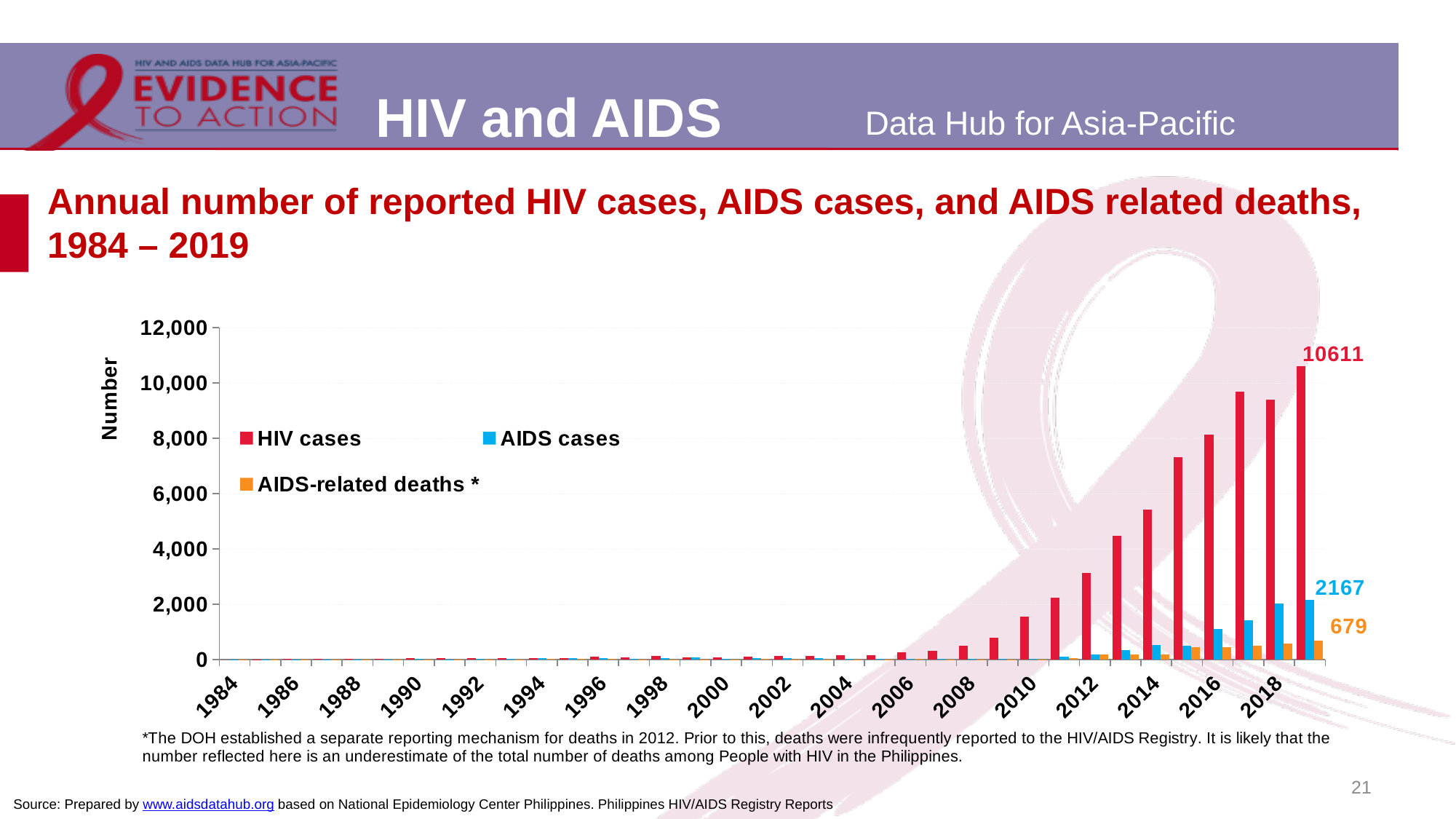
What is the difference between AIDS cases and AIDS-related deaths in 2019? 1488 What is the number of AIDS cases reported in 2019? 2167 Do reported HIV cases rise or fall from 2006 to 2019? Rise Is the value for HIV cases in 2015 greater or less than 8,000? less What is the number of AIDS-related deaths reported in 2019? 679 What is the number of HIV cases reported in 2019? 10611 How many series does the legend list? 3 Which series has the highest value in 2019? HIV cases What is the difference between HIV cases and AIDS cases in 2019? 8444 In which year are reported HIV cases highest? 2019 Is the value for HIV cases in 2017 greater or less than 8,000? greater What kind of chart is shown on the slide? Bar chart